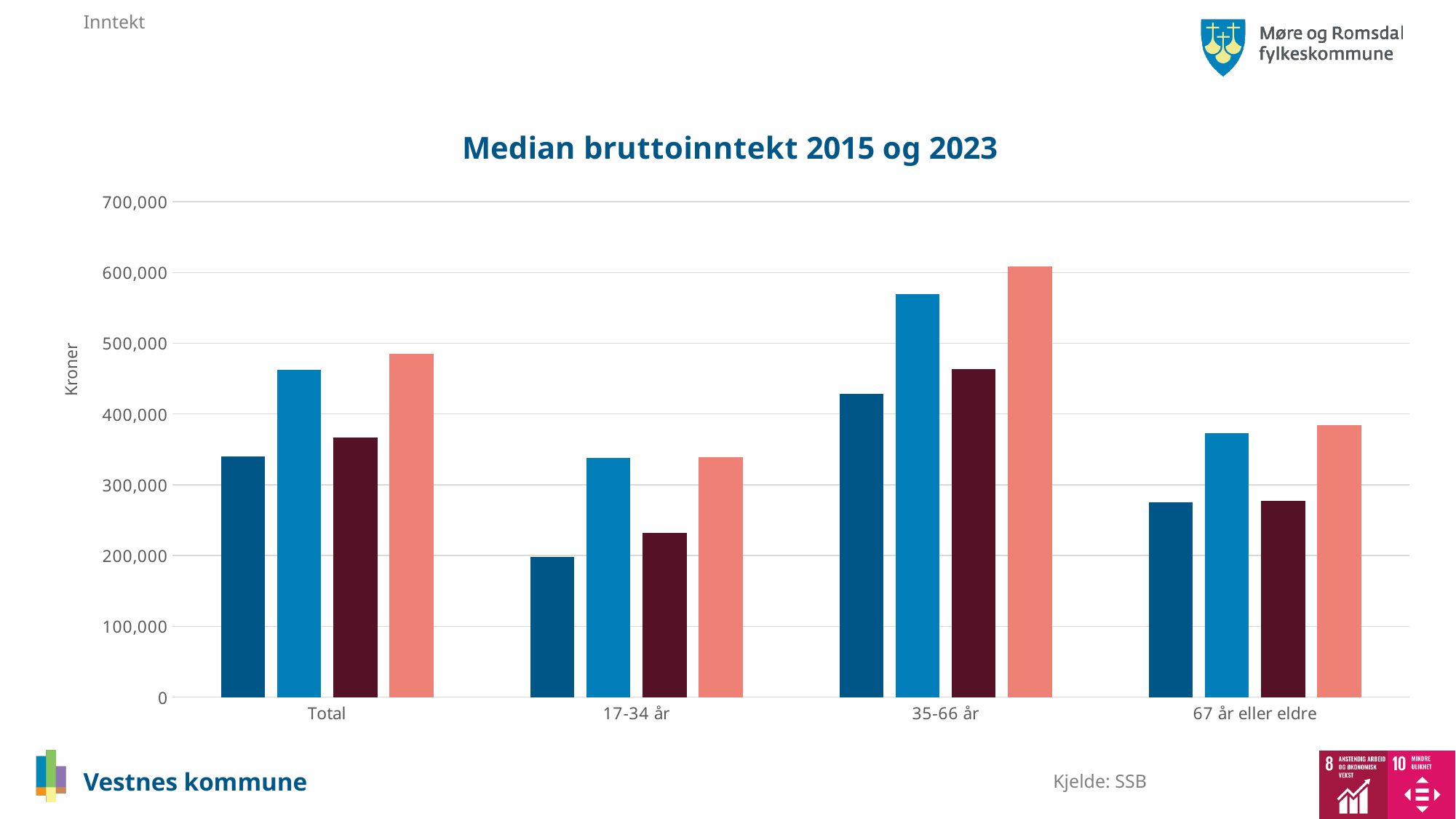
What kind of chart is shown on the slide? bar chart Which category contains the shortest bar in the chart? 17-34 år What is the title of the chart? Median bruttoinntekt 2015 og 2023 Which is larger: the light blue bar for Total or the light blue bar for 67 år eller eldre? Total Is the value of the light blue bar for 67 år eller eldre greater or less than 300,000? greater Is the value of the salmon-coloured bar for 35-66 år greater or less than 500,000? greater Is the value of the dark blue bar for 17-34 år greater or less than 300,000? less How many bars are plotted for each category in the chart? 4 What is the label on the vertical axis of the chart? Kroner Which category contains the tallest bar in the chart? 35-66 år How many categories are shown along the x axis of the chart? 4